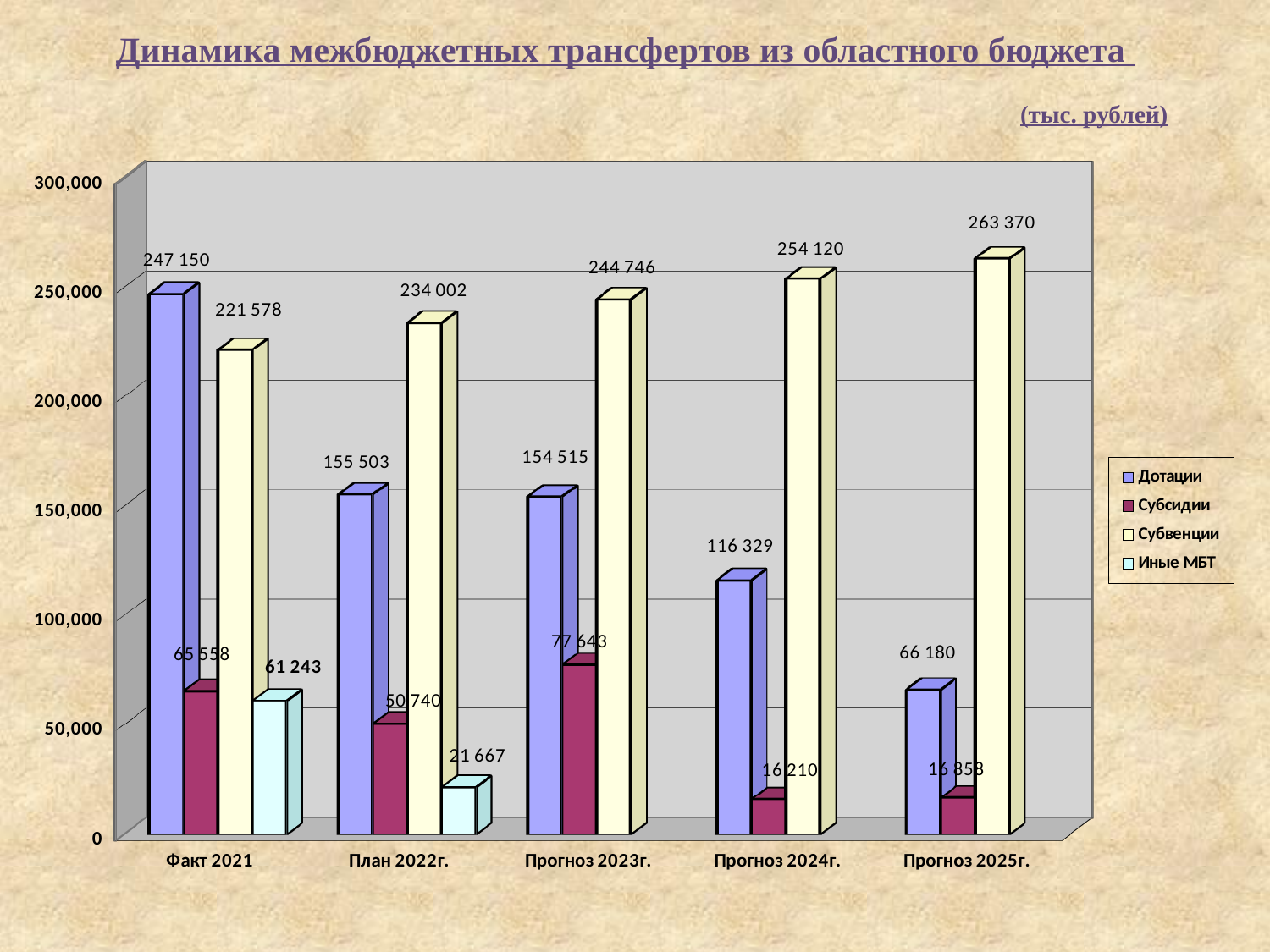
What is the value of Иные МБТ for План 2022г.? 21 667 In which category is the Субвенции value the highest? Прогноз 2025г. What is the difference between the Субвенции value for Прогноз 2025г. and for Факт 2021? 41 792 Do the Субвенции values rise or fall from Факт 2021 to Прогноз 2025г.? rise For Факт 2021, which is larger: Дотации or Субвенции? Дотации What kind of chart is shown on the slide? bar chart How many categories are shown on the x axis? 5 Is the value of Дотации for Прогноз 2024г. greater or less than 100,000? greater In which category is the Дотации value the lowest? Прогноз 2025г. What is the value of Субвенции for Прогноз 2025г.? 263 370 What is the value of Дотации for Факт 2021? 247 150 How many series does the legend list? 4